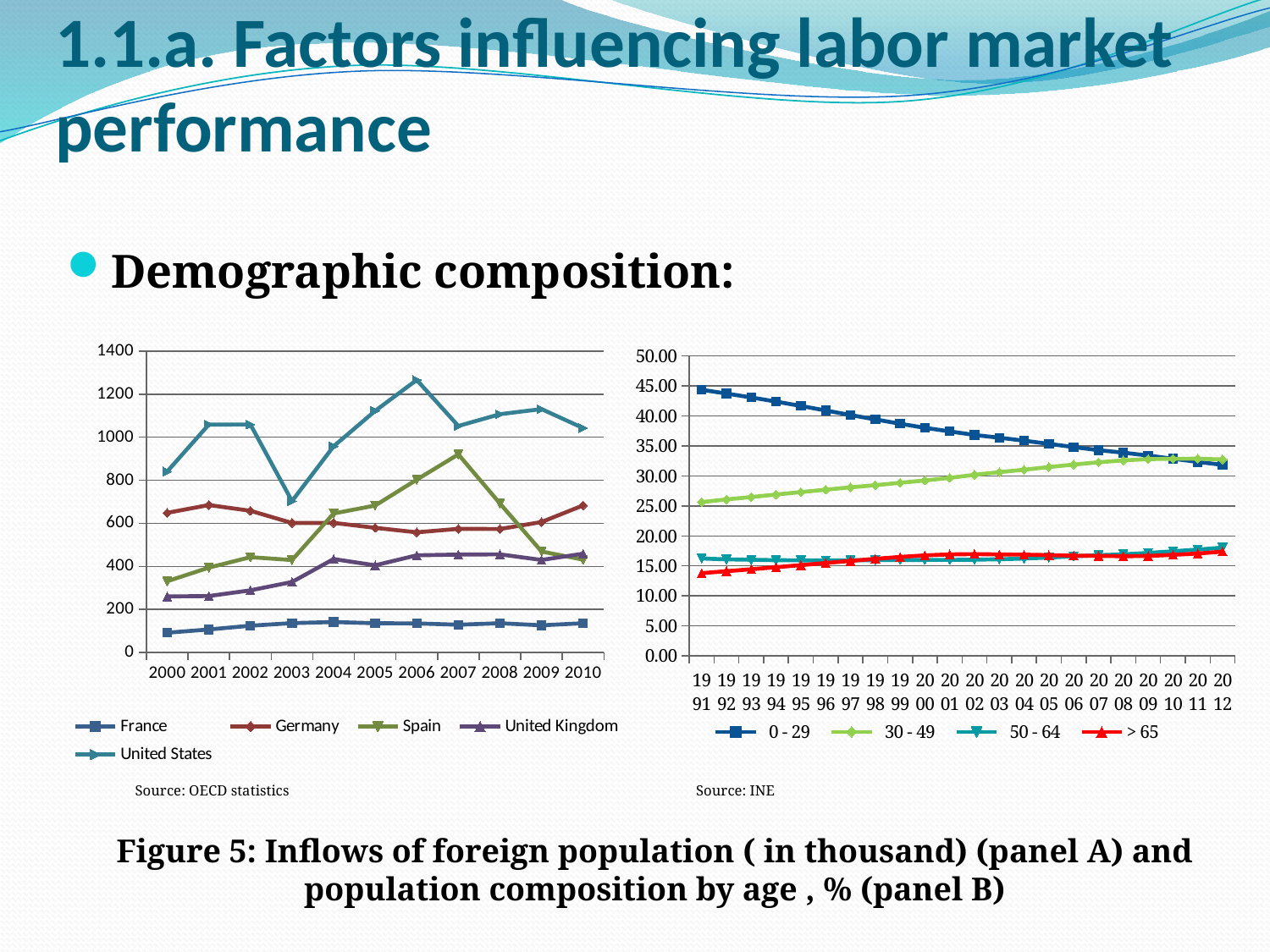
In the right chart (panel B), does the 0 - 29 series rise or fall from 1991 to 2012? fall How many series does the legend of the left chart (panel A) list? 5 How many years are plotted on the x axis of the left chart (panel A)? 11 In the left chart (panel A), which country has the highest inflow in 2006? United States In the left chart (panel A), which country has the lowest inflow in 2010? France In the right chart (panel B), which age group has the highest share in 1991? 0 - 29 In the left chart (panel A), is the value for Spain in 2007 greater or less than 800? greater In the left chart (panel A), which is larger in 2007, the value for Germany or the value for Spain? Spain In the right chart (panel B), is the value for > 65 in 1991 greater or less than 15.00? less What kind of chart is the left chart (panel A)? line chart How many series does the legend of the right chart (panel B) list? 4 In the left chart (panel A), is the value for the United States in 2006 greater or less than 1200? greater